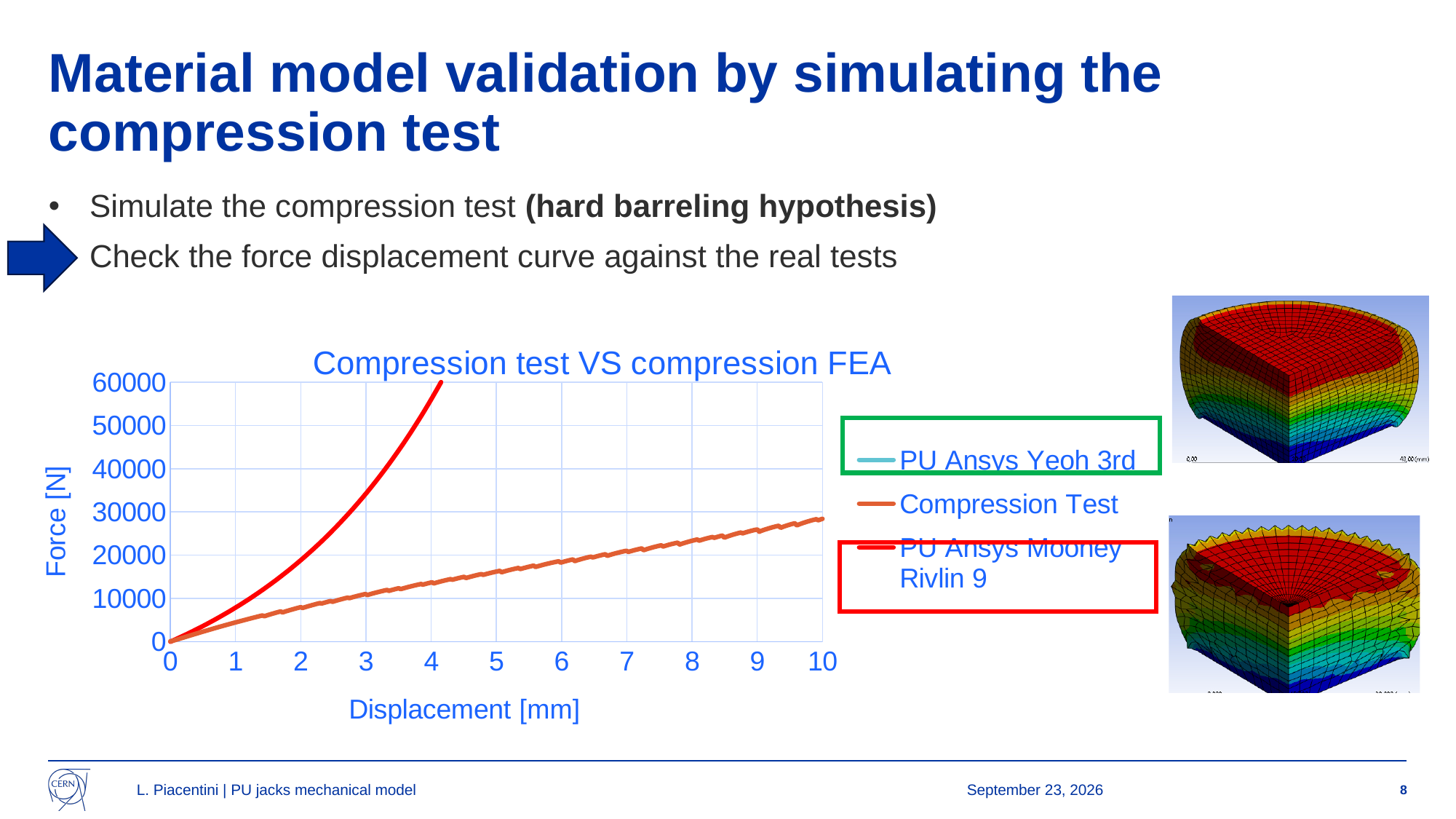
How many series does the chart legend list? 3 Which series reaches the highest force on the chart? PU Ansys Mooney Rivlin 9 What is the title of the chart? Compression test VS compression FEA At a displacement of 3 mm, which series has the higher force: PU Ansys Mooney Rivlin 9 or Compression Test? PU Ansys Mooney Rivlin 9 Does the PU Ansys Mooney Rivlin 9 force rise or fall as displacement increases? rise Does the Compression Test force rise or fall as displacement increases? rise What kind of chart is shown on the slide? line chart What is the label of the y axis of the chart? Force [N] Is the PU Ansys Mooney Rivlin 9 force at a displacement of 2 mm greater or less than 10000? greater Is the Compression Test force at a displacement of 10 mm greater or less than 30000? less Is the PU Ansys Mooney Rivlin 9 force at a displacement of 4 mm greater or less than 50000? greater